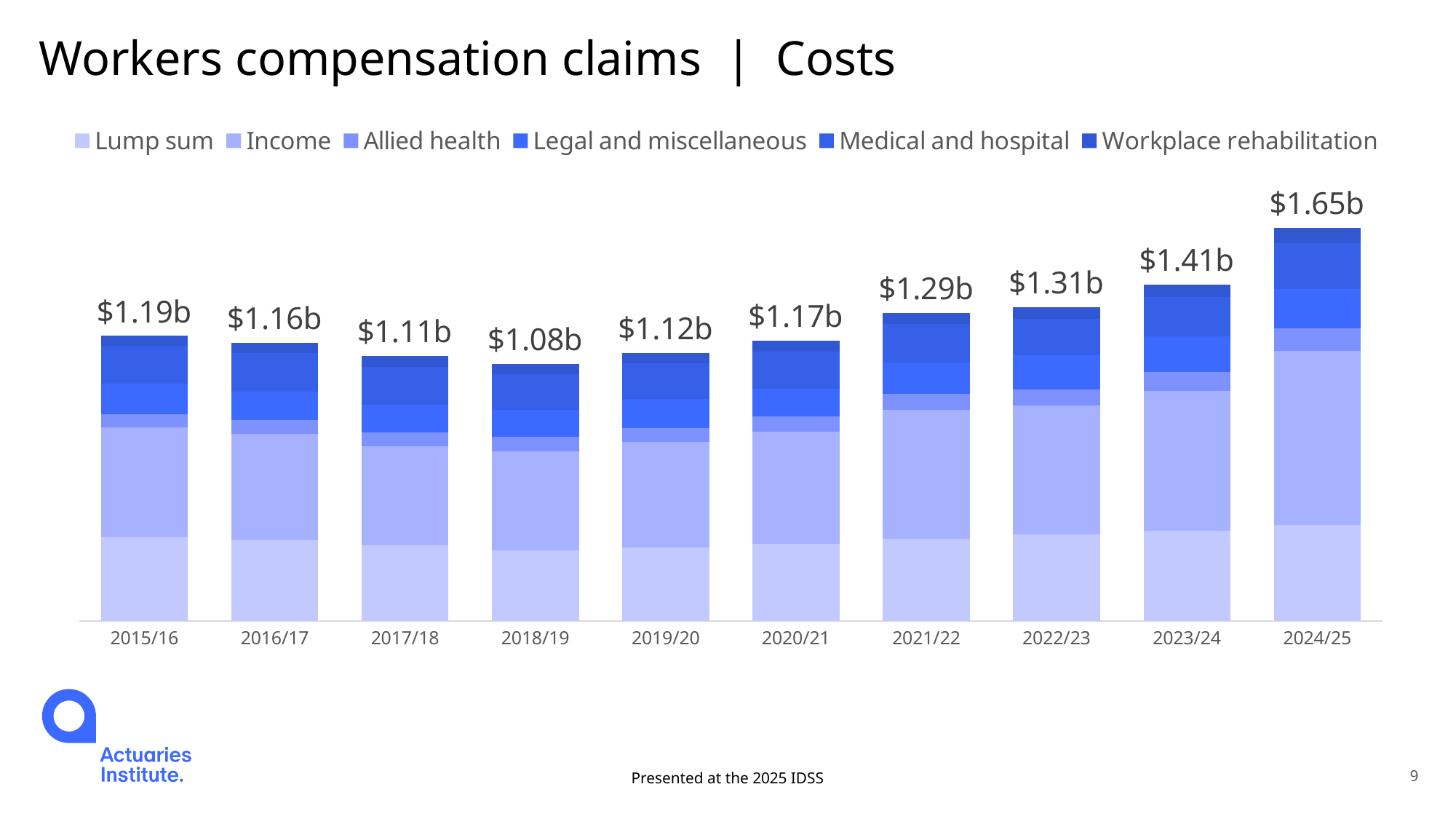
How many cost categories does the legend list? 6 How many financial years are shown on the x axis? 10 Which year has the highest total claims cost? 2024/25 What is the difference between the total cost in 2015/16 and in 2018/19? $0.11b What is the total cost shown for 2020/21? $1.17b Do total claims costs rise or fall from 2018/19 to 2024/25? Rise What is the total workers compensation claims cost shown for 2024/25? $1.65b Which year has the lowest total claims cost? 2018/19 Which year has the larger total cost, 2021/22 or 2022/23? 2022/23 What kind of chart is shown on the slide? Stacked bar chart What is the difference between the total cost in 2024/25 and in 2023/24? $0.24b What is the total cost shown for 2018/19? $1.08b